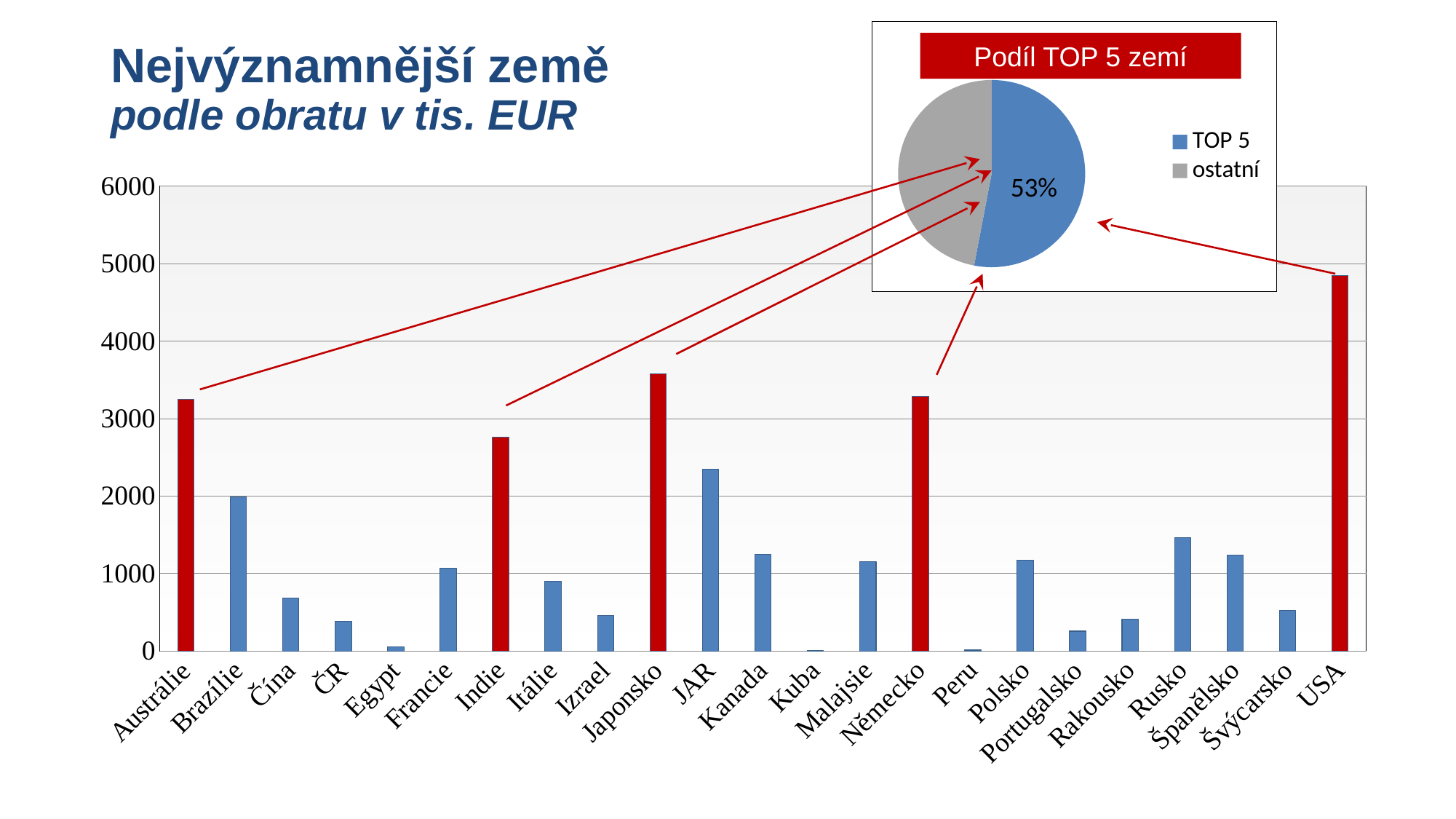
What kind of chart is the large chart at the bottom of the slide? bar chart In the bar chart, which is larger, the value for Japonsko or the value for Indie? Japonsko How many entries does the legend of the pie chart "Podíl TOP 5 zemí" list? 2 In the pie chart "Podíl TOP 5 zemí", what share does the TOP 5 slice have? 53% In the bar chart, which country has the highest value? USA In the bar chart, is the value for Japonsko greater or less than 3000? greater In the bar chart, is the value for USA greater or less than 4000? greater What kind of chart is the chart titled "Podíl TOP 5 zemí"? pie chart How many bars in the bar chart are coloured red? 5 In the bar chart, is the value for Čína greater or less than 1000? less How many countries are shown on the x axis of the bar chart? 23